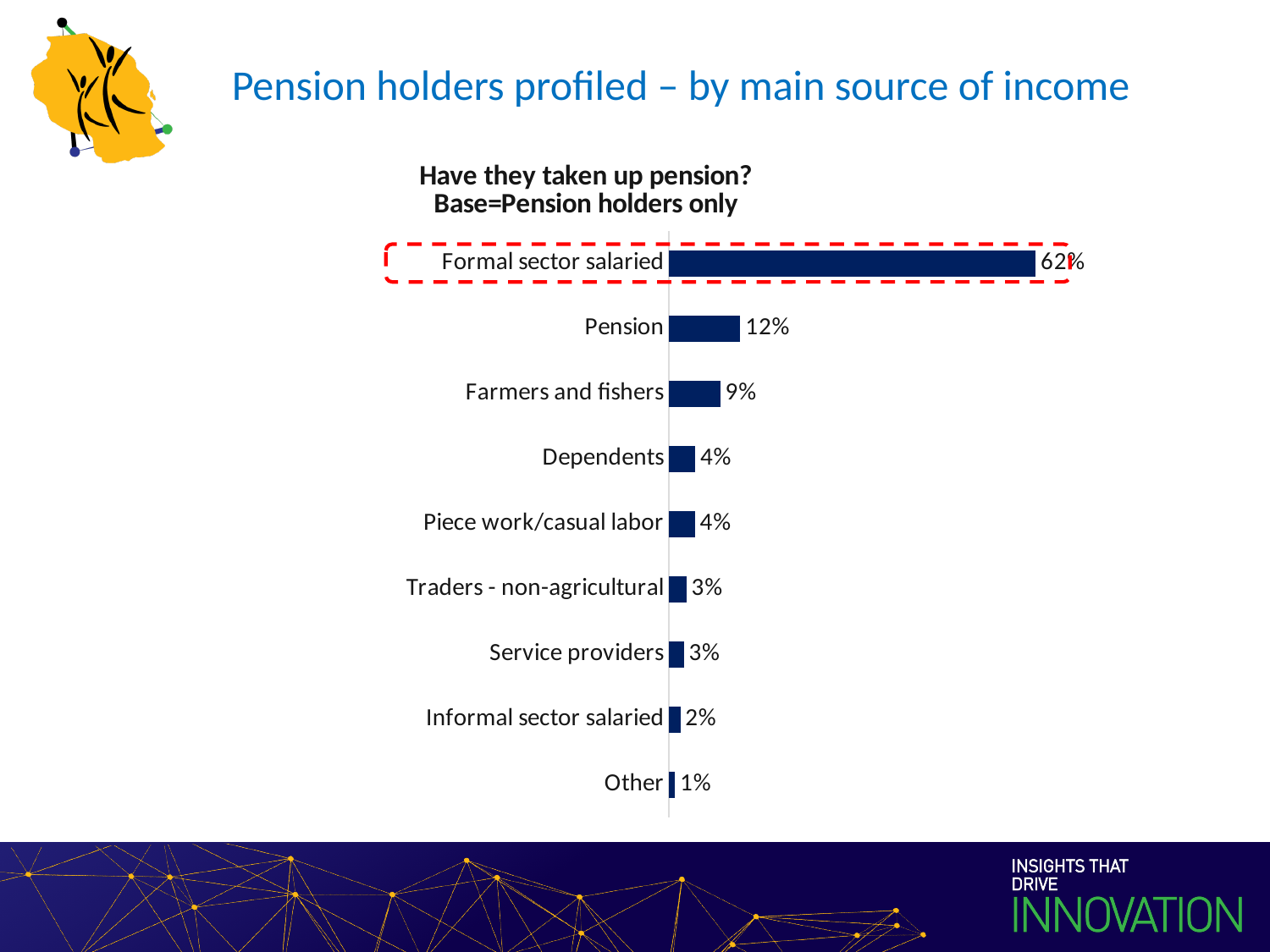
Which category has the lowest value? Other Which is larger, the value for Pension or the value for Dependents? Pension What is the value for Informal sector salaried? 2% What is the value for Formal sector salaried? 62% What is the value for Farmers and fishers? 9% What kind of chart is shown on the slide? Bar chart What is the difference between the values for Pension and Farmers and fishers? 3% Which category is highlighted with a red dashed outline? Formal sector salaried What is the title of the chart? Have they taken up pension? Base=Pension holders only How many categories are shown in the chart? 9 What is the difference between the values for Formal sector salaried and Pension? 50% Which category has the highest value? Formal sector salaried